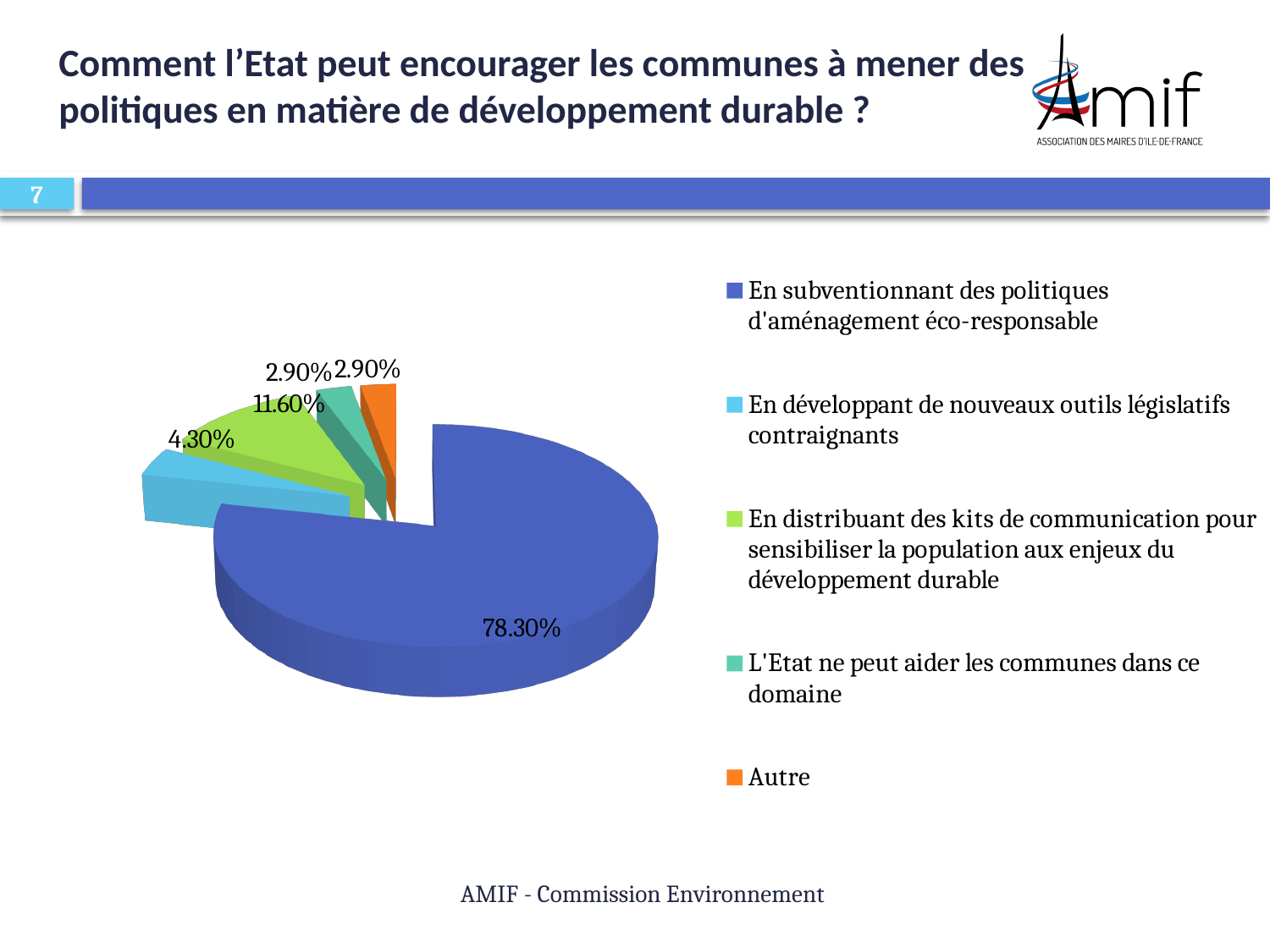
What percentage is shown for 'En développant de nouveaux outils législatifs contraignants'? 4.30% Which legend entry corresponds to the teal/green slice labelled 2.90% next to the orange slice? L'Etat ne peut aider les communes dans ce domaine What colour is the slice for 'Autre'? Orange What percentage is shown for 'Autre'? 2.90% What percentage is shown for 'En distribuant des kits de communication pour sensibiliser la population aux enjeux du développement durable'? 11.60% What is the smallest percentage value shown on the pie chart? 2.90% What share of the pie is labelled for 'En subventionnant des politiques d'aménagement éco-responsable'? 78.30% Which is larger: the slice for 'En distribuant des kits de communication...' or the slice for 'En développant de nouveaux outils législatifs contraignants'? En distribuant des kits de communication pour sensibiliser la population aux enjeux du développement durable Which category has the largest slice of the pie? En subventionnant des politiques d'aménagement éco-responsable What kind of chart is shown on the slide? Pie chart How many slices does the pie chart have? 5 What is the difference between the largest slice (78.30%) and the 'kits de communication' slice (11.60%)? 66.70%